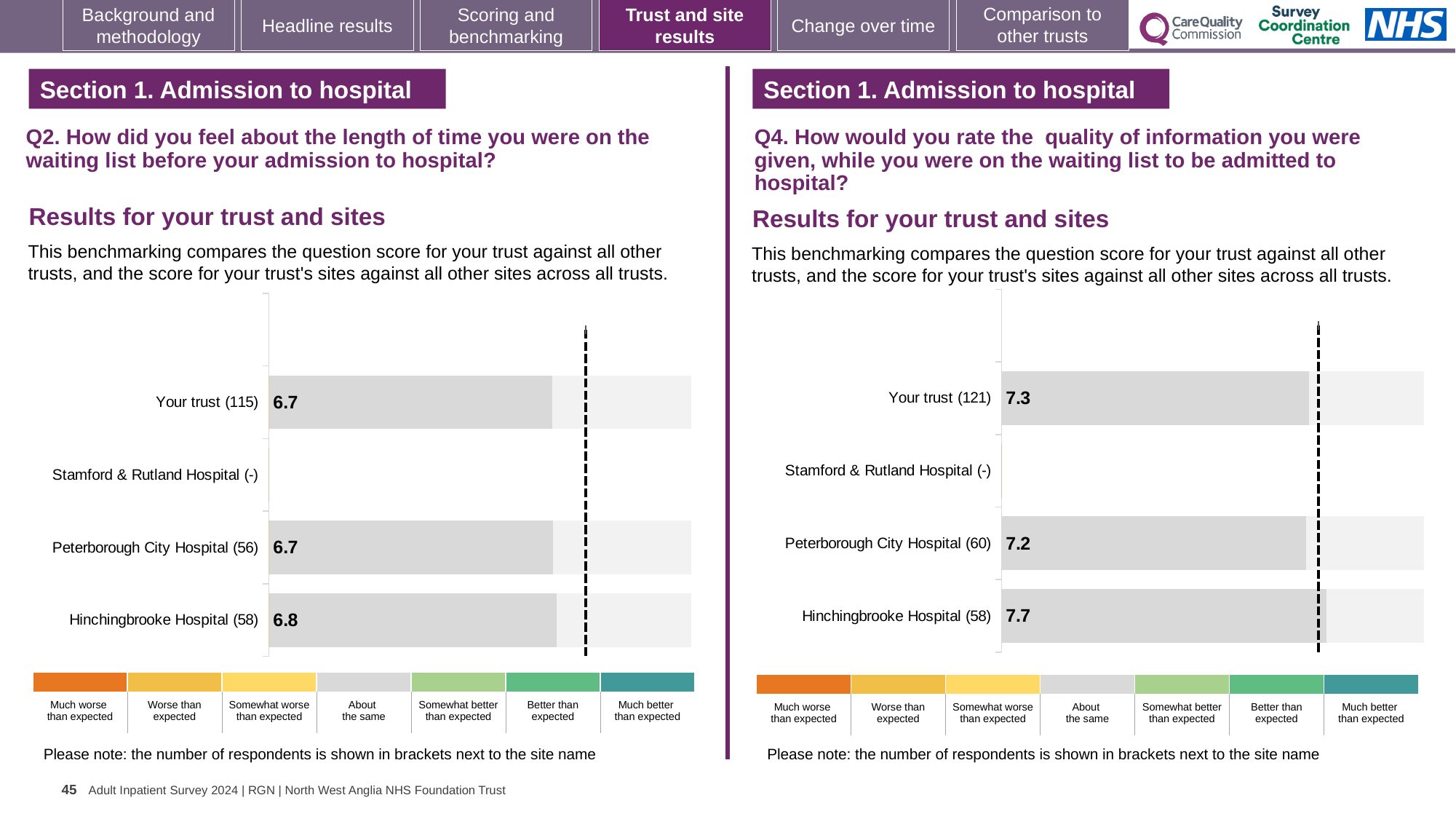
On the right chart (Q4), which is larger: the score for Your trust or the score for Hinchingbrooke Hospital? Hinchingbrooke Hospital On the left chart (Q2), how many respondents are shown in brackets for Peterborough City Hospital? 56 On the right chart (Q4), what is the score for Peterborough City Hospital? 7.2 How many rows (trust and sites) are listed on the left chart (Q2)? 4 On the right chart (Q4), which row has the lowest printed score? Peterborough City Hospital On the right chart (Q4), what is the score for Your trust? 7.3 On the right chart (Q4), which site has the highest score? Hinchingbrooke Hospital What kind of chart is used on the right (Q4)? Bar chart On the left chart (Q2), what is the score for Hinchingbrooke Hospital? 6.8 On the left chart (Q2), what is the score for Your trust? 6.7 On the right chart (Q4), what is the difference between the scores for Hinchingbrooke Hospital and Peterborough City Hospital? 0.5 On the left chart (Q2), what is the difference between the scores for Hinchingbrooke Hospital and Your trust? 0.1